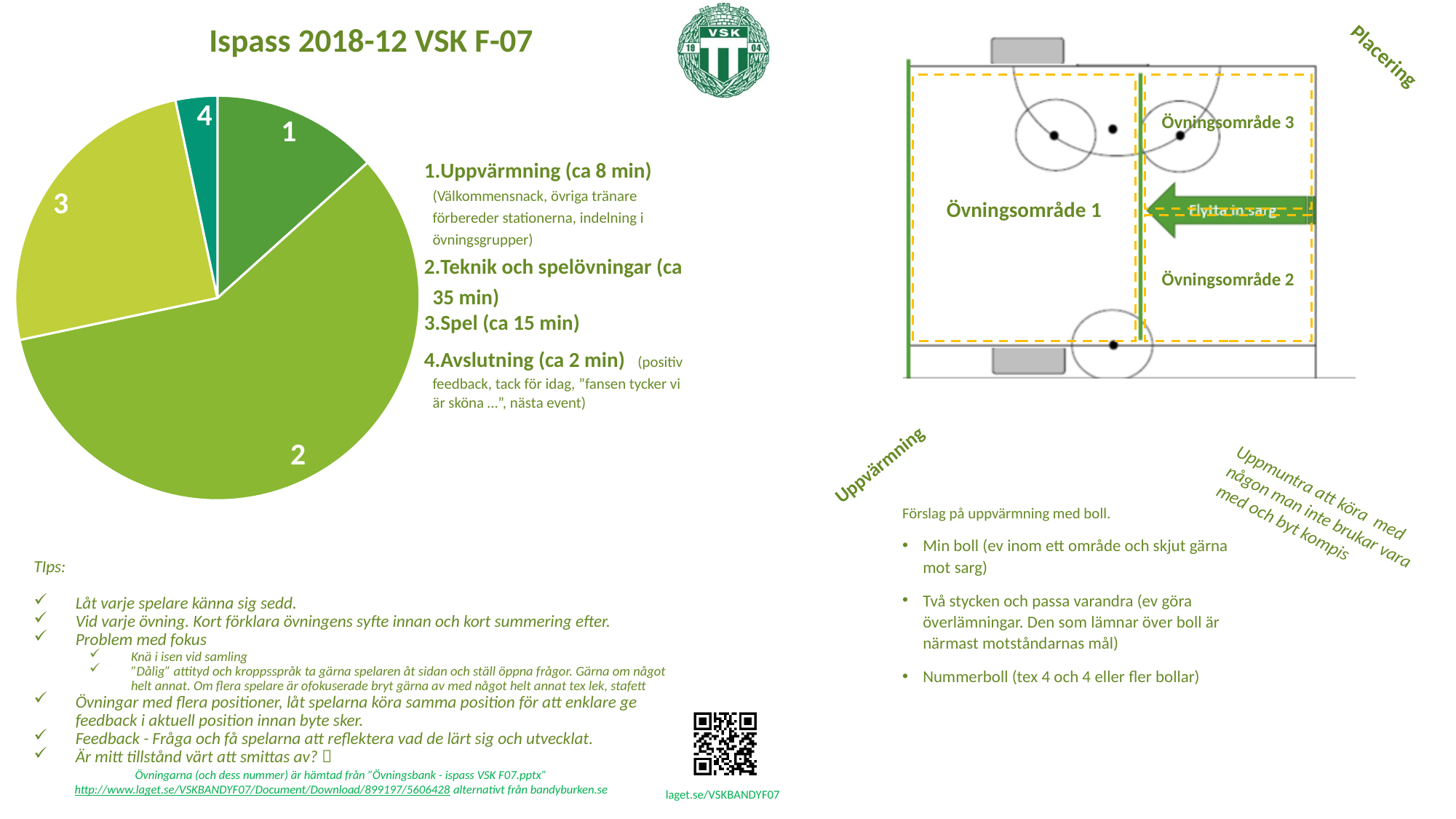
What is the title of the slide containing the pie chart? Ispass 2018-12 VSK F-07 Which slice of the pie chart is the smallest? 4 In the pie chart, which slice is larger, slice 1 or slice 3? 3 How many slices does the pie chart have? 4 In the pie chart, which slice is larger, slice 1 or slice 4? 1 Does slice 2 of the pie chart take up more or less than half of the pie? more What kind of chart is shown on the left of the slide? pie chart In the pie chart, which slice is larger, slice 2 or slice 3? 2 What colour is slice 4 of the pie chart? teal Which slice of the pie chart is the largest? 2